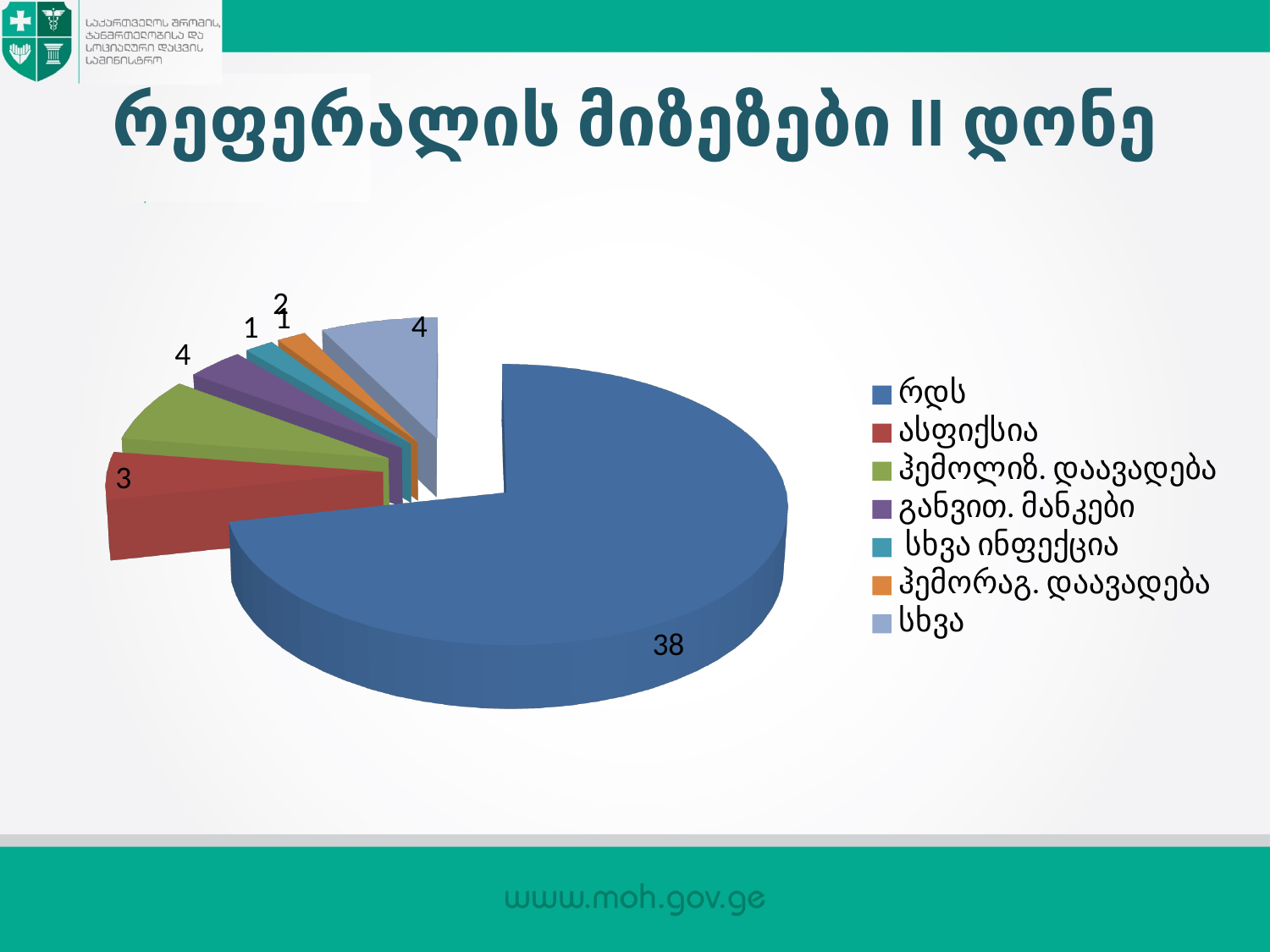
What is the difference between the values for რდს and ასფიქსია? 35 What is the title of the slide containing the pie chart? რეფერალის მიზეზები II დონე What is the value for ასფიქსია? 3 What is the value for განვით. მანკები? 2 How many categories does the pie chart have? 7 What is the value for ჰემოლიზ. დაავადება? 4 Which is larger, the value for ჰემოლიზ. დაავადება or the value for ასფიქსია? ჰემოლიზ. დაავადება What is the total of all the values in the pie chart? 53 What kind of chart is shown on the slide? Pie chart What is the value for რდს? 38 Which category has the largest slice in the pie chart? რდს What is the value for სხვა? 4